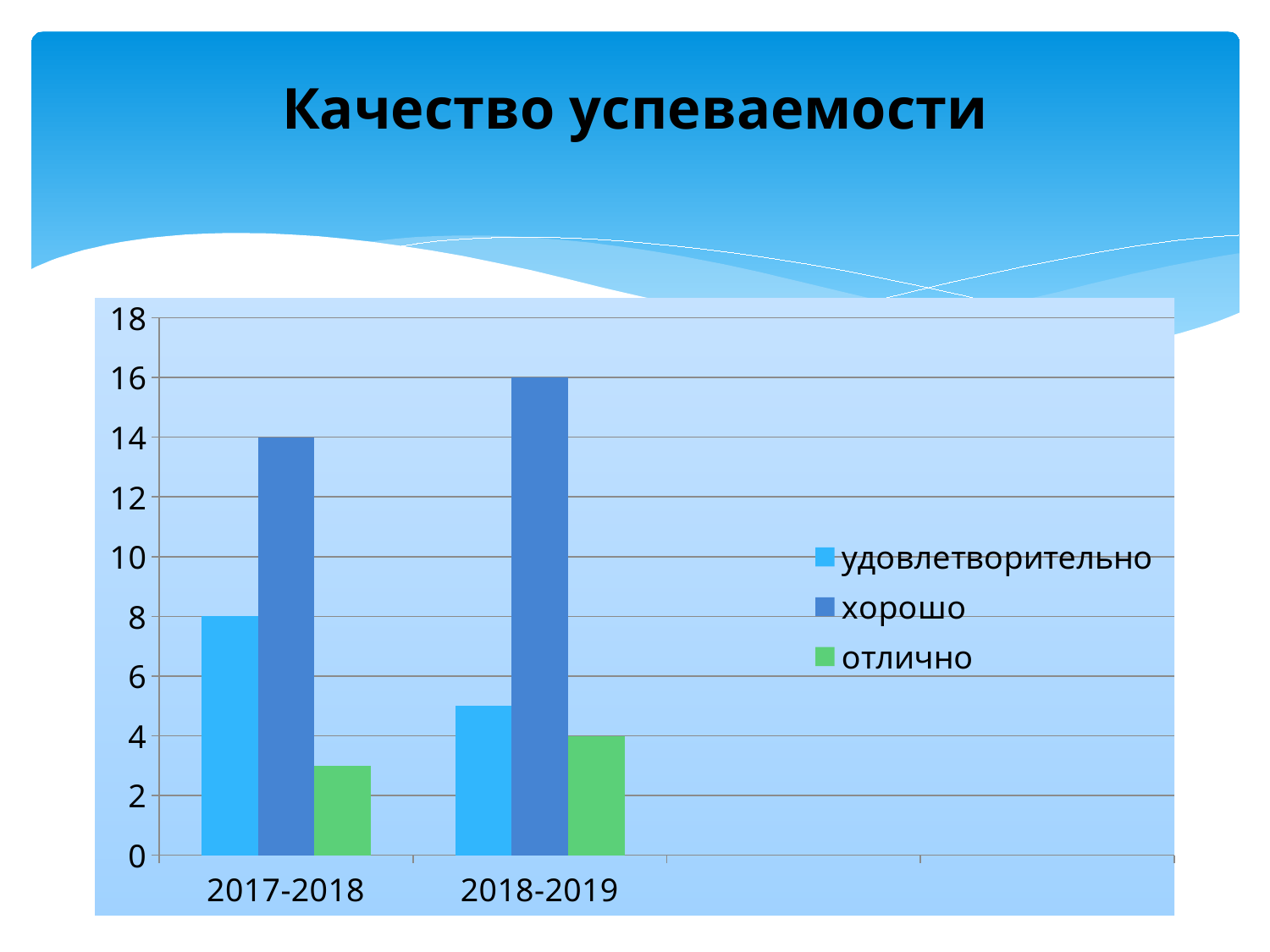
How many categories are shown on the x axis? 2 What is the difference between the хорошо values for 2018-2019 and 2017-2018? 2 What is the value for удовлетворительно in 2017-2018? 8 Which is larger: удовлетворительно in 2017-2018 or удовлетворительно in 2018-2019? 2017-2018 Which series has the tallest bar in 2018-2019? хорошо What is the title of the chart? Качество успеваемости What type of chart is shown on the slide? Bar chart What is the value for отлично in 2018-2019? 4 How many series does the legend list? 3 Is the value for отлично in 2017-2018 greater or less than 4? less What is the value for хорошо in 2017-2018? 14 What is the value for хорошо in 2018-2019? 16